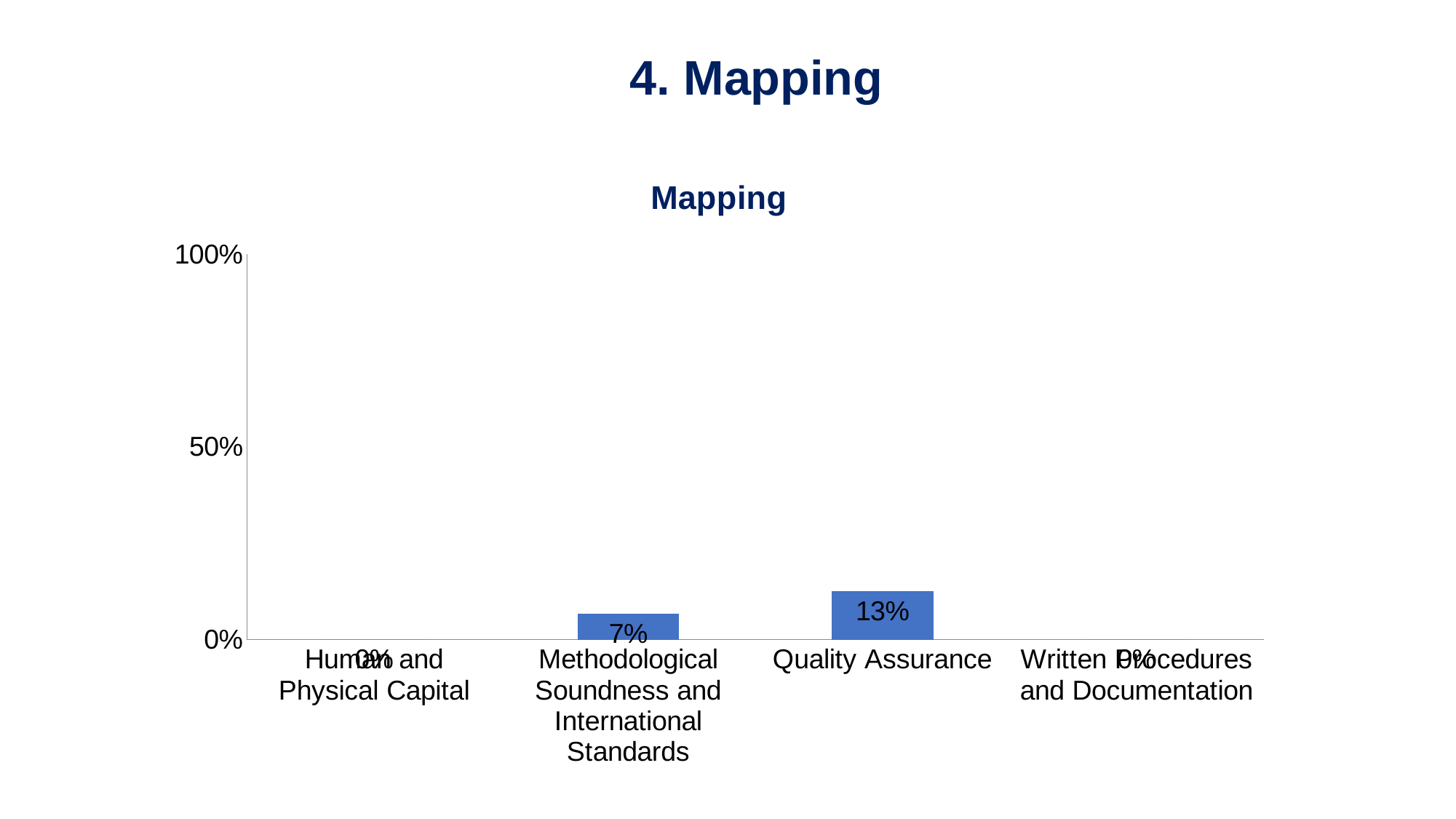
What is the value for Written Procedures and Documentation? 0% What is the title of the chart? Mapping What is the difference between the values for Quality Assurance and Methodological Soundness and International Standards? 6% Which is larger, the value for Quality Assurance or the value for Methodological Soundness and International Standards? Quality Assurance What is the value for Human and Physical Capital? 0% Is the value for Quality Assurance greater or less than 50%? less Which category has the highest value? Quality Assurance What is the value for Methodological Soundness and International Standards? 7% What kind of chart is shown on the slide? bar chart What is the highest value shown on the y axis? 100% What is the value for Quality Assurance? 13% How many categories are shown on the x axis? 4